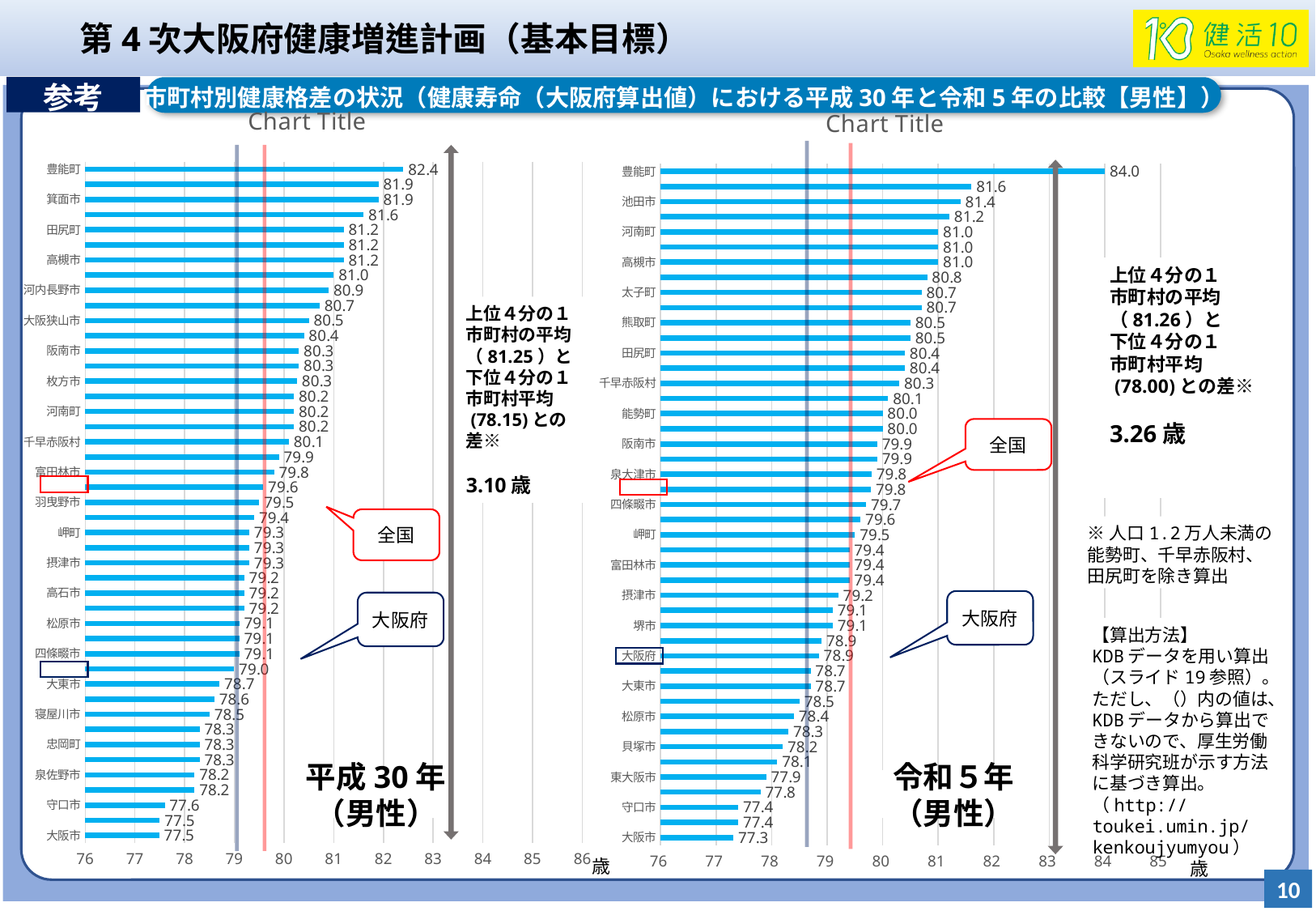
In the right chart (令和5年（男性）), what is the difference between 豊能町 and 大阪市? 6.7 In the right chart (令和5年（男性）), what is the value for 大阪府? 78.9 In the right chart (令和5年（男性）), is the value for 池田市 greater or less than 80? greater In the right chart (令和5年（男性）), which category has the lowest value? 大阪市 In the left chart (平成30年（男性）), what is the value for 豊能町? 82.4 In the left chart (平成30年（男性）), which is larger, the value for 高槻市 or the value for 守口市? 高槻市 In the left chart (平成30年（男性）), which category has the highest value? 豊能町 In the left chart (平成30年（男性）), what is the value for 大阪市? 77.5 In the right chart (令和5年（男性）), what is the value for 豊能町? 84.0 In the left chart (平成30年（男性）), what is the value for 河内長野市? 80.9 What kind of chart is the left chart (平成30年（男性）)? bar chart In the right chart (令和5年（男性）), what is the value for 東大阪市? 77.9